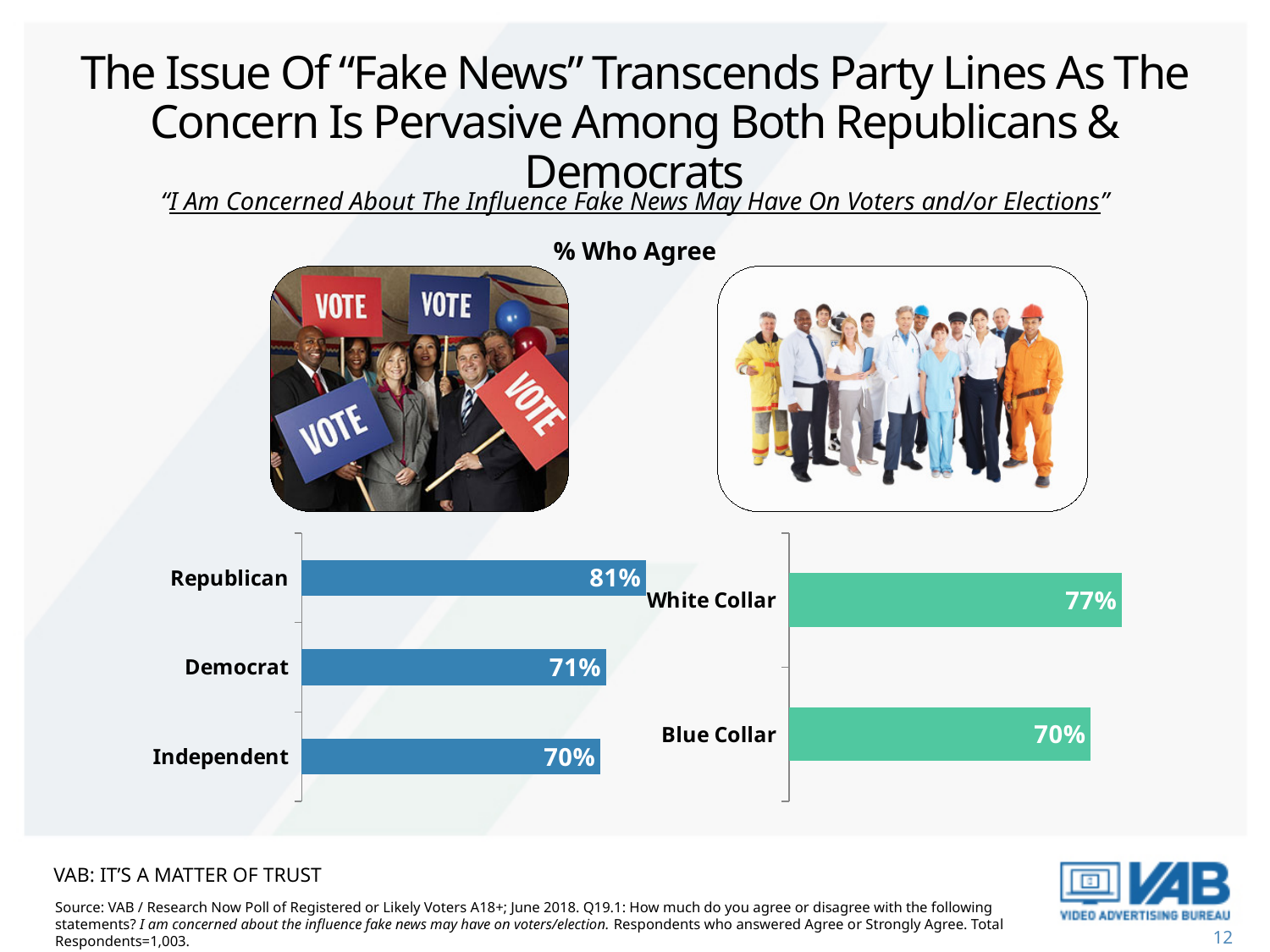
How many categories are shown in the left chart (party affiliation)? 3 What type of chart is used on this slide? Bar chart In the left chart (party affiliation), what percentage of Independents agree? 70% In the left chart (party affiliation), what percentage of Republicans agree? 81% In the left chart (party affiliation), which group has the highest percentage who agree? Republican In the right chart (occupation), what percentage of Blue Collar respondents agree? 70% In the right chart (occupation), what percentage of White Collar respondents agree? 77% In the left chart (party affiliation), which group has the lowest percentage who agree? Independent In the right chart (occupation), which group has a higher percentage who agree, White Collar or Blue Collar? White Collar In the left chart (party affiliation), what is the difference between the Republican and Democrat percentages? 10% In the right chart (occupation), what is the difference between the White Collar and Blue Collar percentages? 7% In the left chart (party affiliation), what percentage of Democrats agree? 71%